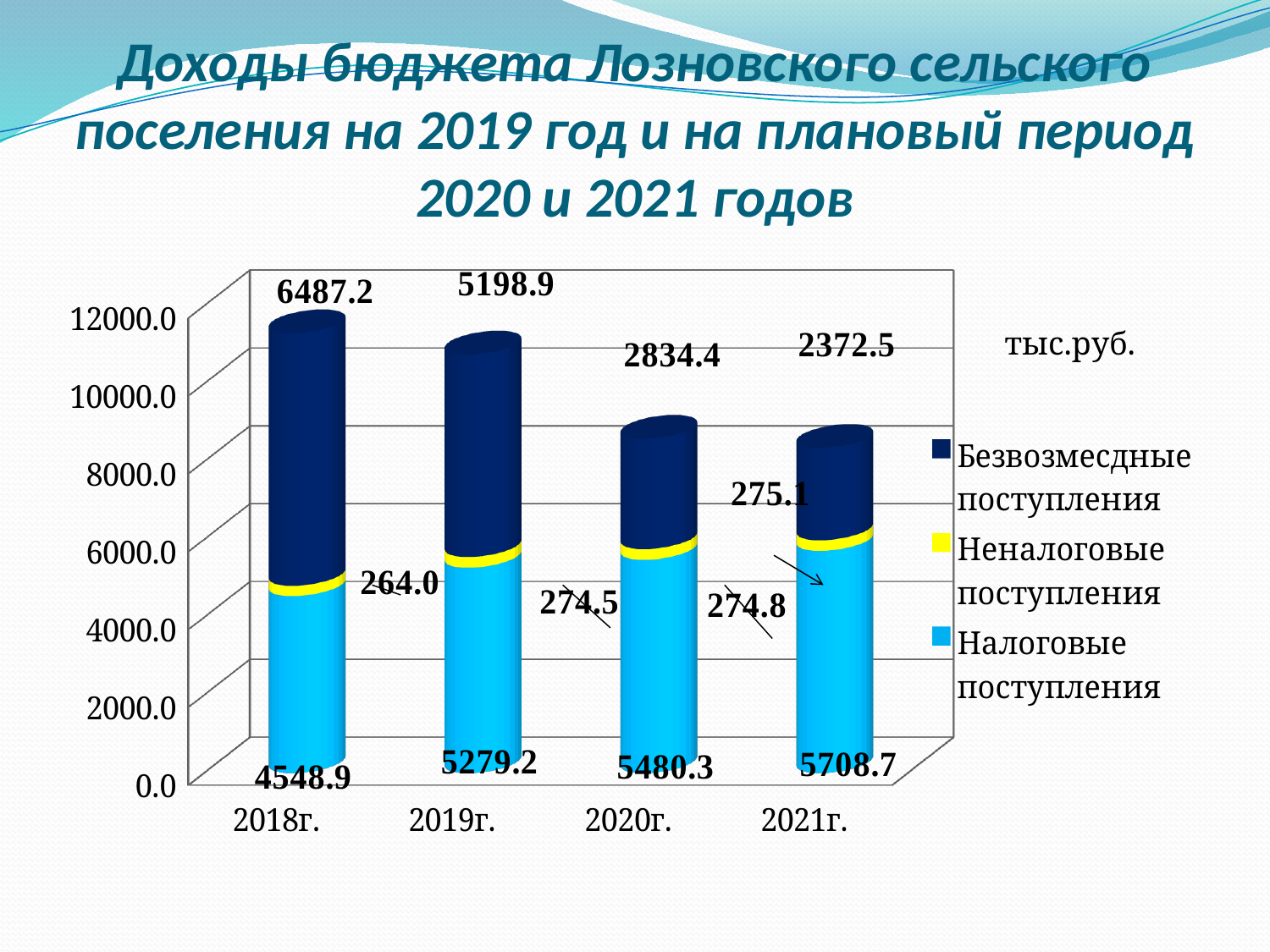
What type of chart is shown on the slide? stacked bar chart Which is larger in 2019г.: Налоговые поступления or Безвозмесдные поступления? Налоговые поступления What is the total of the stacked bar for 2021г.? 8356.3 In which year is Налоговые поступления lowest? 2018г. How many series does the legend list? 3 How many years (categories) are shown on the x axis? 4 What is the difference between Безвозмесдные поступления in 2018г. and 2021г.? 4114.7 In which year is Безвозмесдные поступления highest? 2018г. What is the value of Налоговые поступления for 2019г.? 5279.2 What is the value of Безвозмесдные поступления for 2020г.? 2834.4 What is the value of Неналоговые поступления for 2018г.? 264.0 Do the values of Безвозмесдные поступления rise or fall from 2018г. to 2021г.? fall